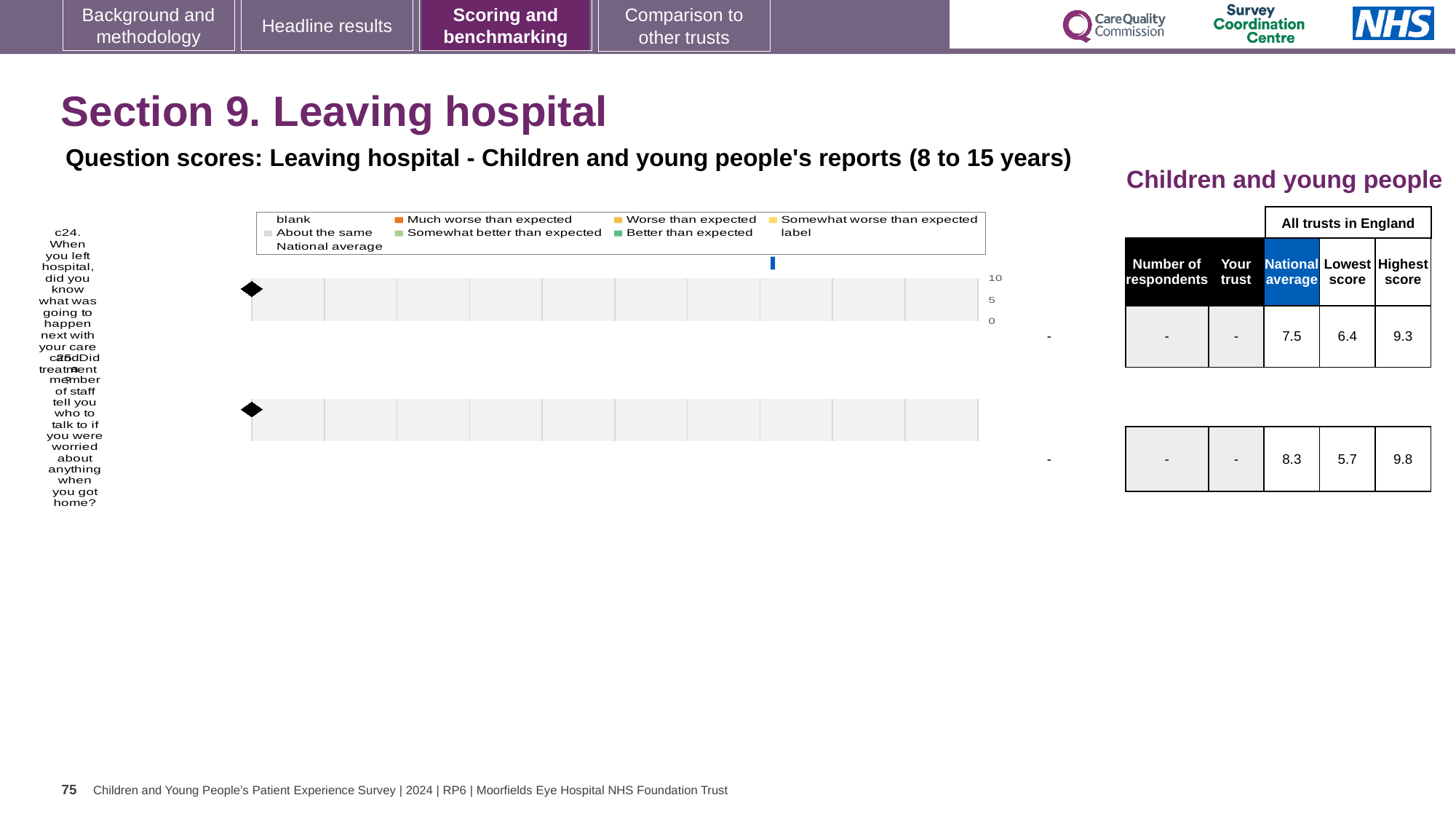
How many question rows (categories) does the chart show? 2 What is the highest value shown on the chart's axis? 10 Which question has the higher national average in the table, c24 or c25? c25 In the table beside the chart, what is the highest score for question c25? 9.8 How many entries does the chart's legend list? 9 What kind of chart is used for the question scores on this slide? bar chart Which legend entry is shown with an orange marker? Much worse than expected What value is shown for 'Your trust' for question c24 in the table? - In the table beside the chart, what is the national average for question c25 (did a member of staff tell you who to talk to if you were worried when you got home)? 8.3 What is the difference between the highest score and the lowest score for question c24 in the table? 2.9 In the table beside the chart, what is the lowest score for question c24? 6.4 In the table beside the chart, what is the national average for question c24 (did you know what was going to happen next with your care and treatment)? 7.5